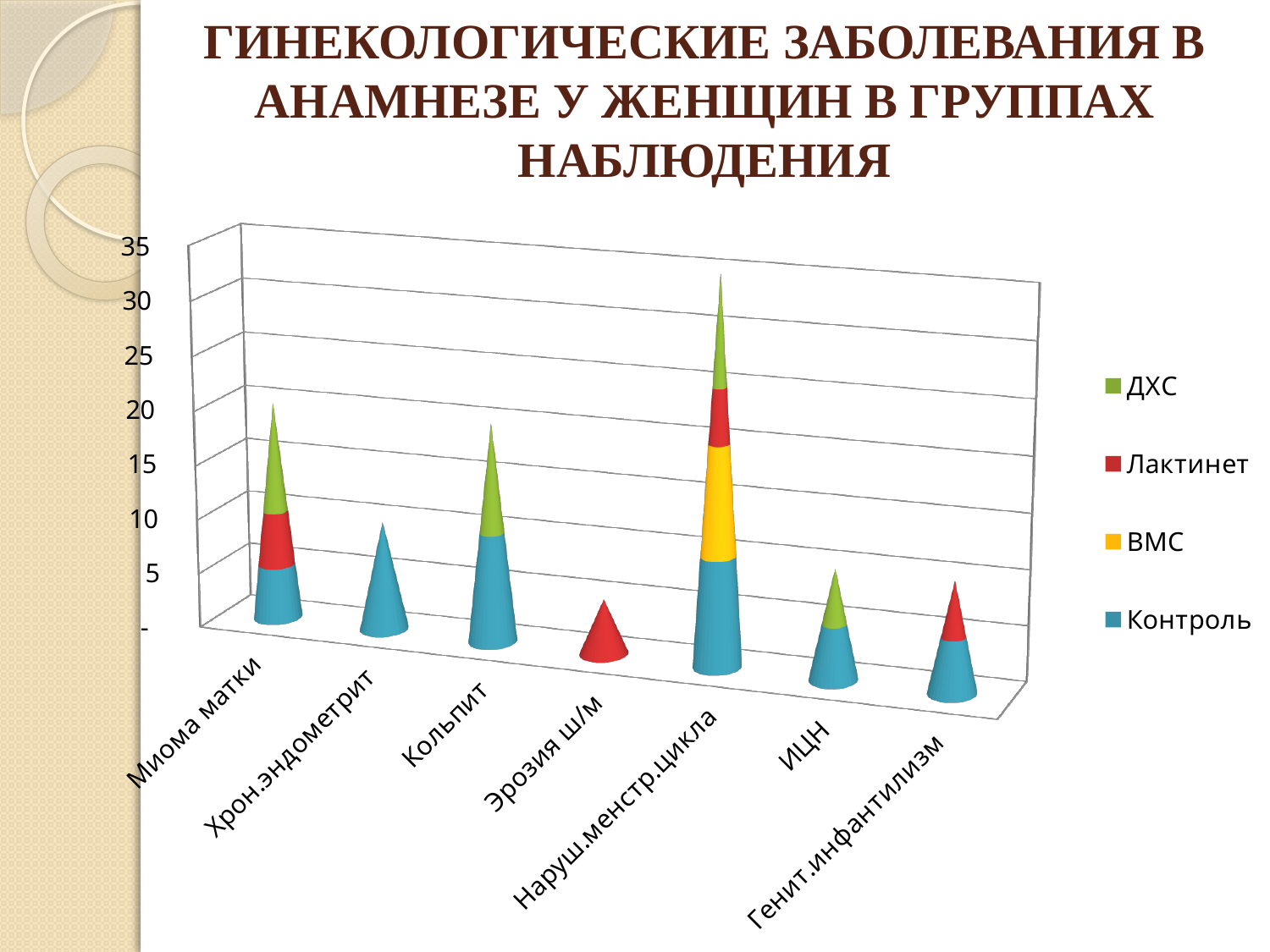
What kind of chart is shown on the slide? bar chart Is the total value for Хрон.эндометрит greater or less than 5? greater Which category is the only one that includes the ВМС series? Наруш.менстр.цикла Which series is the only one present for the category Эрозия ш/м? Лактинет Which category has the lowest total stacked value? Эрозия ш/м How many series does the chart legend list? 4 How many categories are shown on the x axis of the chart? 7 Which has the larger total value, Миома матки or Хрон.эндометрит? Миома матки Which has the larger total value, Наруш.менстр.цикла or ИЦН? Наруш.менстр.цикла Is the total value for Наруш.менстр.цикла greater or less than 20? greater Is the total value for Миома матки greater or less than 10? greater Which category has the highest total stacked value? Наруш.менстр.цикла